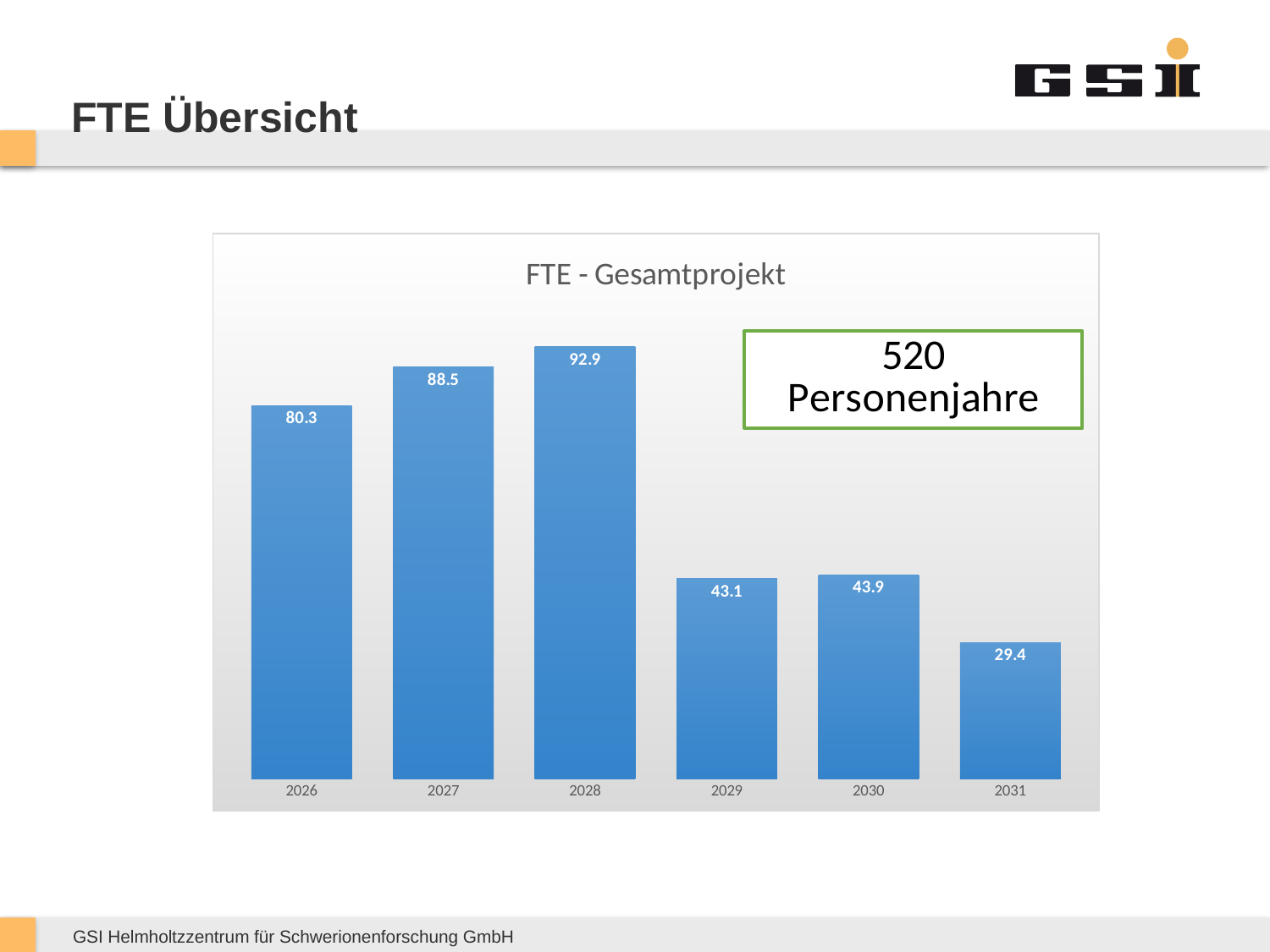
What is the FTE value for 2026? 80.3 What is the difference between the FTE values for 2028 and 2026? 12.6 What is the FTE value for 2030? 43.9 What is the title of the chart? FTE - Gesamtprojekt What is the FTE value for 2031? 29.4 Which year has the highest FTE value? 2028 Which year has the lowest FTE value? 2031 What is the FTE value for 2028? 92.9 How many years are shown on the x axis of the chart? 6 What kind of chart is shown on the slide? Bar chart What is the difference between the FTE values for 2027 and 2029? 45.4 Which year has a larger FTE value, 2027 or 2030? 2027